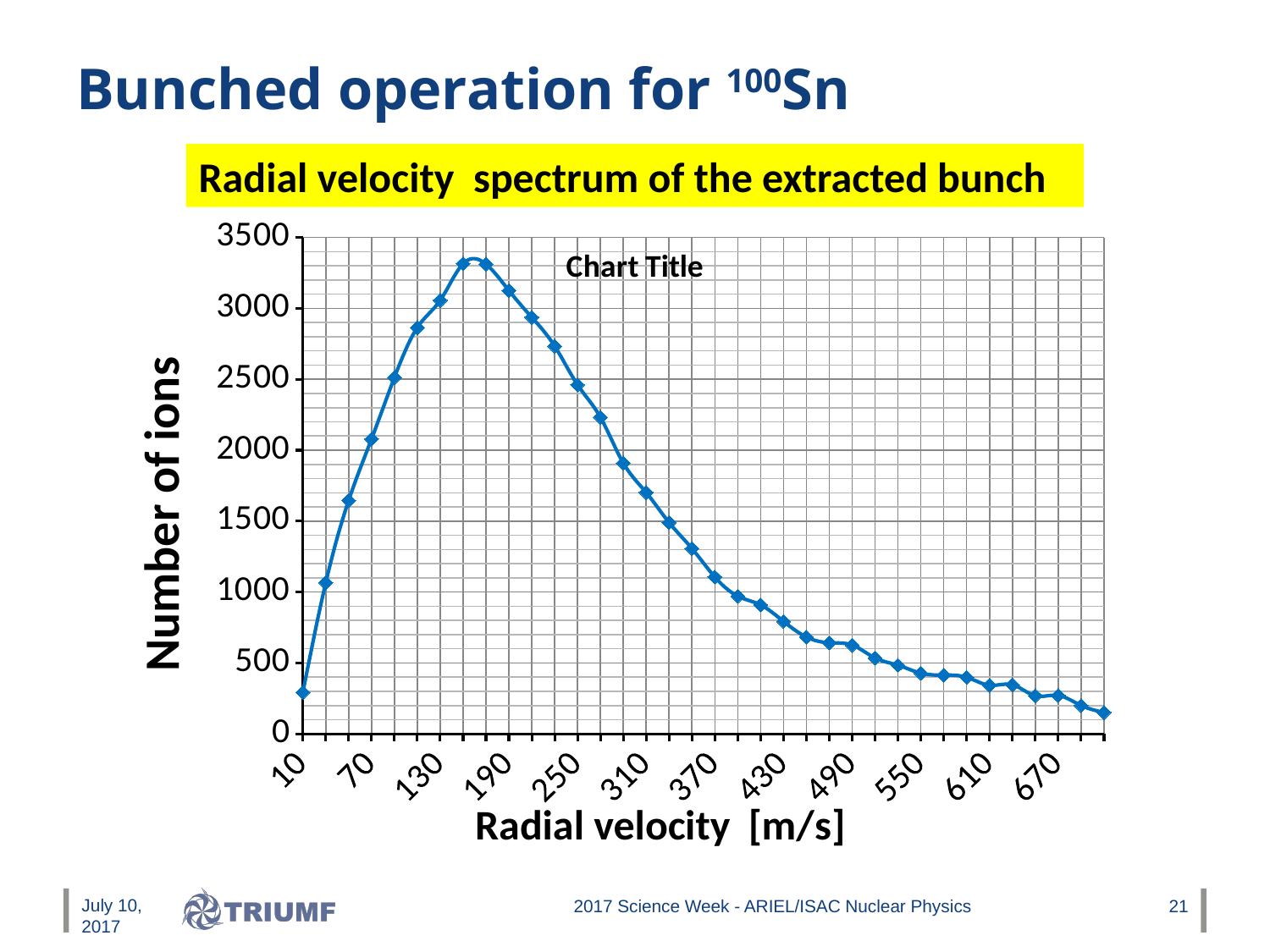
Is the number of ions at a radial velocity of 10 m/s greater or less than 500? less Which has more ions: a radial velocity of 70 m/s or 430 m/s? 70 m/s What is the x-axis title of the chart? Radial velocity [m/s] Between which two labeled x-axis ticks does the number of ions reach its peak? 130 and 190 What is the y-axis title of the chart? Number of ions What kind of chart is shown on the slide? line chart Is the number of ions at a radial velocity of 70 m/s greater or less than 1500? greater Is the number of ions at a radial velocity of 190 m/s greater or less than 3000? greater Does the number of ions rise or fall as radial velocity increases from 190 m/s to 670 m/s? fall